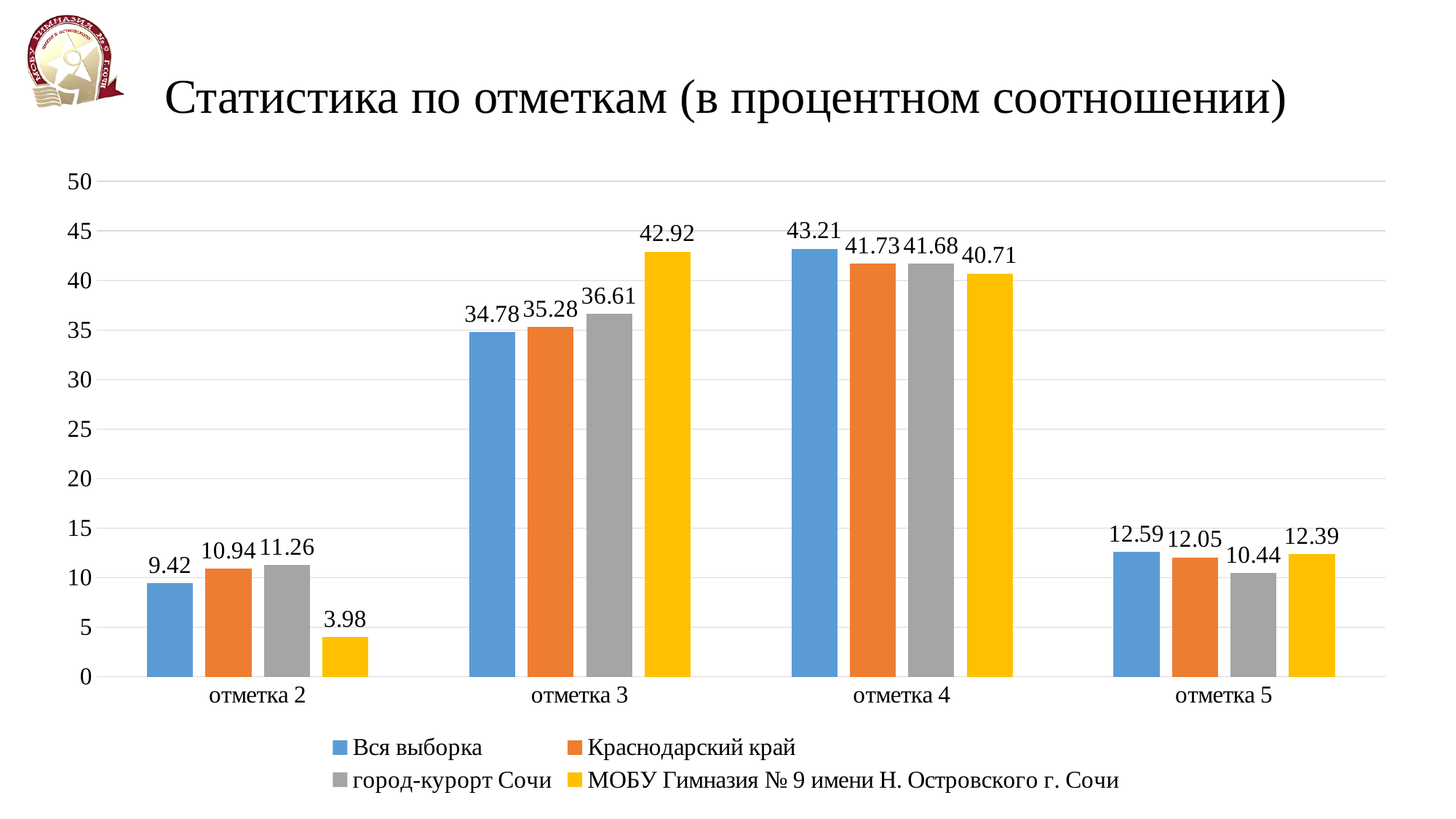
What is the difference between the МОБУ Гимназия № 9 value and the Вся выборка value at отметка 3? 8.14 What is the value for город-курорт Сочи at отметка 3? 36.61 What type of chart is shown on the slide? bar chart What is the value for Краснодарский край at отметка 5? 12.05 Is the value for Краснодарский край at отметка 4 greater or less than 40? greater What is the value for МОБУ Гимназия № 9 имени Н. Островского г. Сочи at отметка 2? 3.98 Which is larger at отметка 5: the value for Вся выборка or the value for город-курорт Сочи? Вся выборка What is the value for Вся выборка at отметка 4? 43.21 How many series does the legend list? 4 How many categories are shown on the x axis? 4 Which series has the highest value at отметка 3? МОБУ Гимназия № 9 имени Н. Островского г. Сочи Which series has the lowest value at отметка 2? МОБУ Гимназия № 9 имени Н. Островского г. Сочи